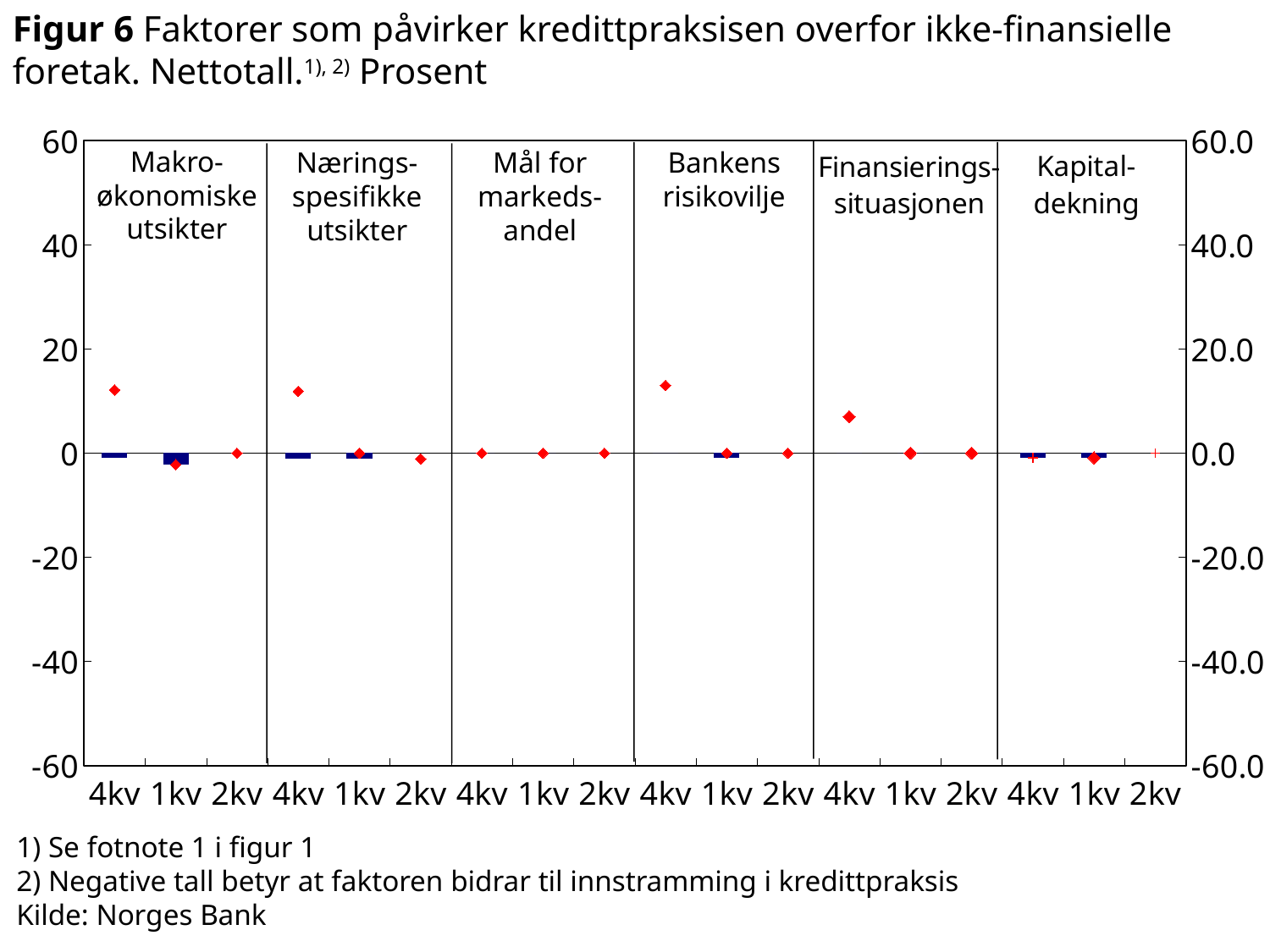
How many quarters are shown on the x axis within each factor panel? 3 Is the red marker for Næringsspesifikke utsikter in 4kv greater or less than 0? greater Which is larger in 4kv: the red marker for Bankens risikovilje or for Mål for markedsandel? Bankens risikovilje Is the red marker for Makroøkonomiske utsikter in 4kv greater or less than 20? less What kind of chart is shown in Figur 6? combination bar and line chart Is the red marker for Finansieringssituasjonen in 4kv greater or less than 0? greater Does the red marker for Bankens risikovilje rise or fall from 4kv to 1kv? fall What is the source given below the chart? Norges Bank Which is larger in 4kv: the red marker for Makroøkonomiske utsikter or for Finansieringssituasjonen? Makroøkonomiske utsikter How many factor panels are shown in the chart? 6